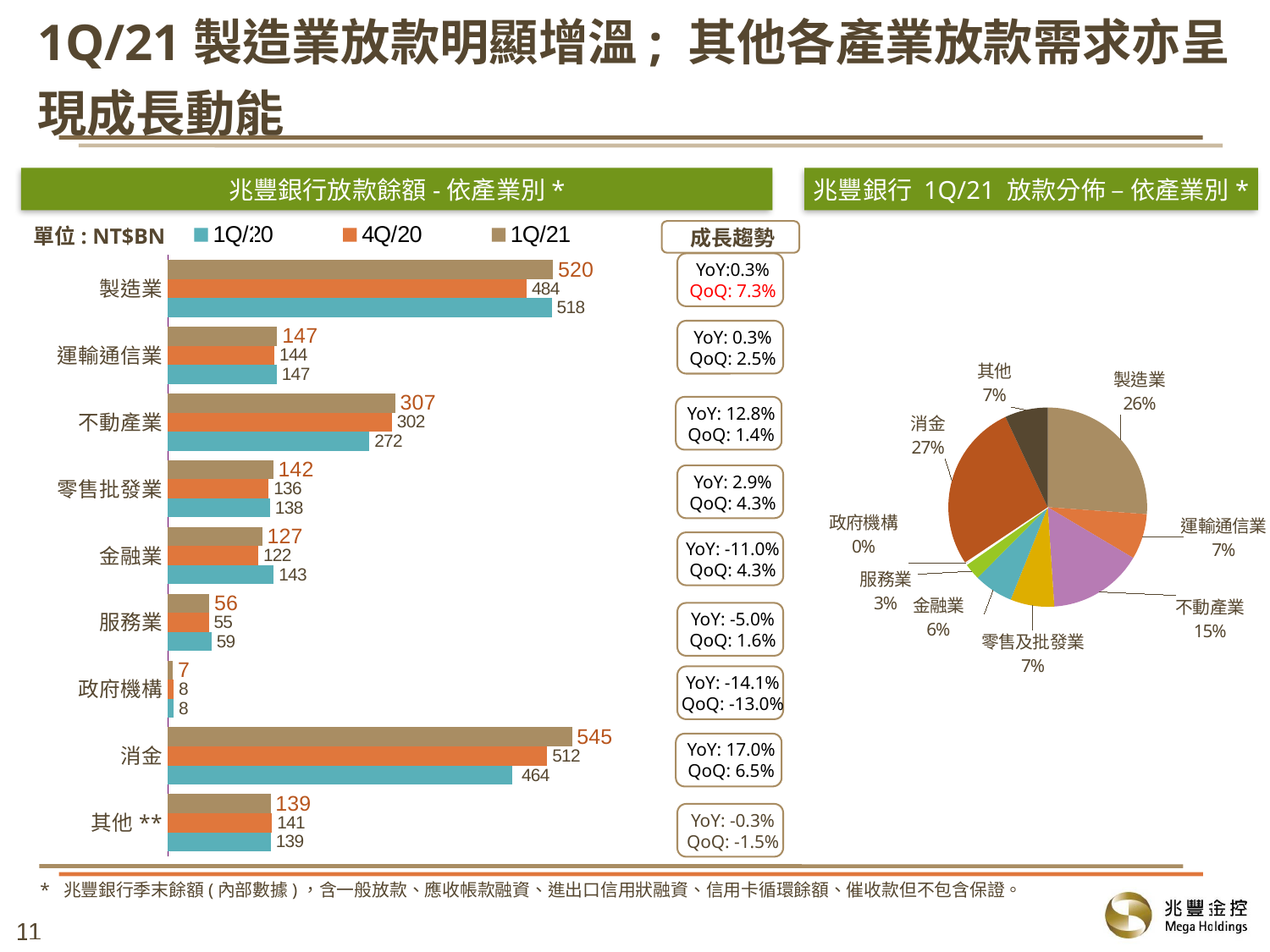
What kind of chart is 兆豐銀行 1Q/21 放款分佈 – 依產業別? pie chart In the bar chart 兆豐銀行放款餘額 - 依產業別, what is the difference between the 1Q/21 and 4Q/20 values for 製造業? 36 In the pie chart 兆豐銀行 1Q/21 放款分佈 – 依產業別, which slice is the largest? 消金 In the bar chart 兆豐銀行放款餘額 - 依產業別, which category has the highest 1Q/21 value? 消金 In the bar chart 兆豐銀行放款餘額 - 依產業別, which category has the lowest 1Q/21 value? 政府機構 In the pie chart 兆豐銀行 1Q/21 放款分佈 – 依產業別, what share does 不動產業 have? 15% In the bar chart 兆豐銀行放款餘額 - 依產業別, which is larger for 金融業: the 1Q/20 value or the 1Q/21 value? 1Q/20 In the bar chart 兆豐銀行放款餘額 - 依產業別, what is the 1Q/20 value for 不動產業? 272 How many categories are shown in the bar chart 兆豐銀行放款餘額 - 依產業別? 9 In the bar chart 兆豐銀行放款餘額 - 依產業別, what is the 1Q/21 value for 消金? 545 In the bar chart 兆豐銀行放款餘額 - 依產業別, what is the 4Q/20 value for 製造業? 484 How many series does the legend of the bar chart 兆豐銀行放款餘額 - 依產業別 list? 3